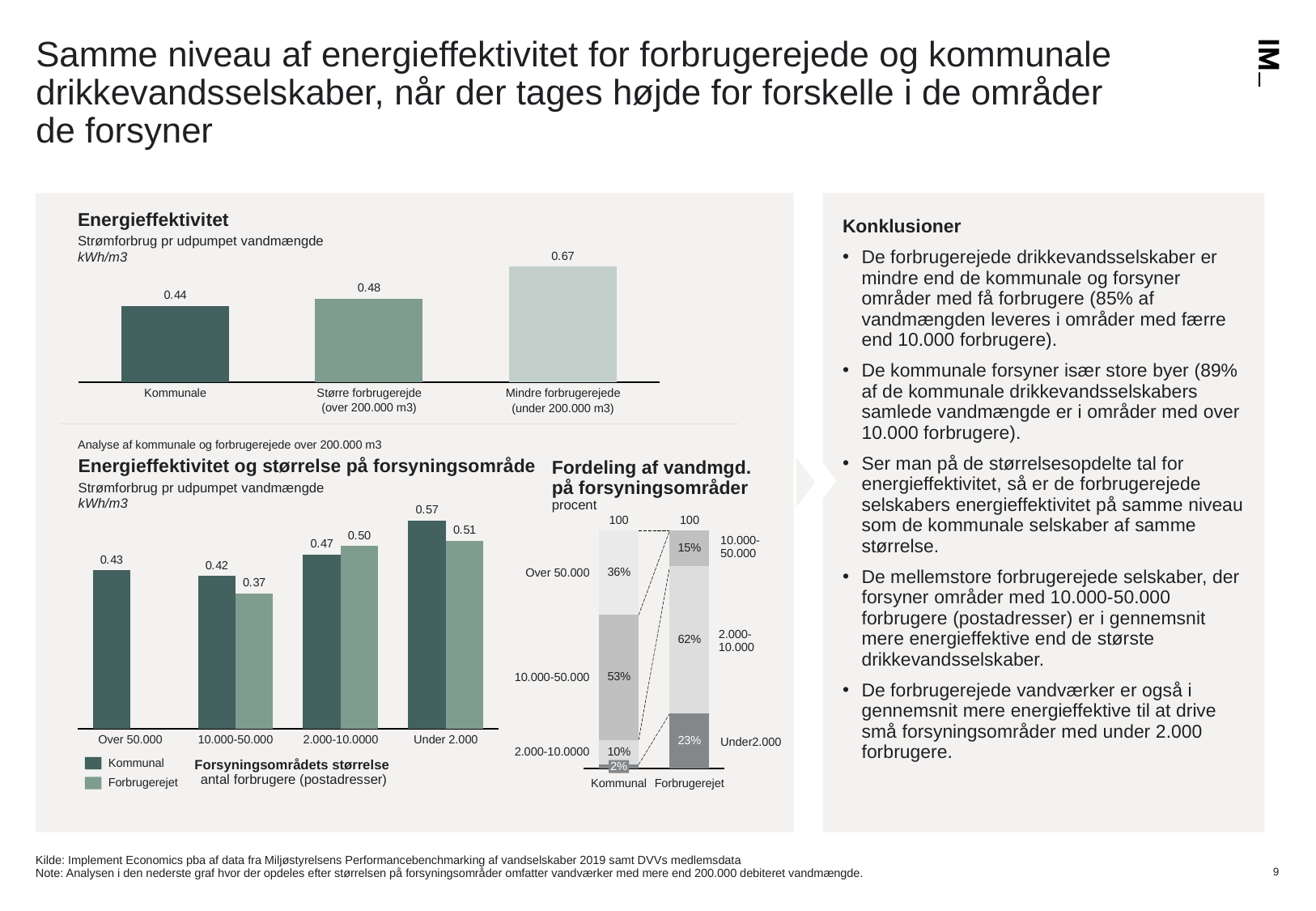
In the 'Energieffektivitet' chart, how many categories are shown? 3 In the 'Energieffektivitet' chart, what is the difference between Mindre forbrugerejede and Kommunale? 0.23 In the 'Energieffektivitet og størrelse på forsyningsområde' chart, which is larger for 2.000-10.0000: Kommunal or Forbrugerejet? Forbrugerejet In the 'Energieffektivitet og størrelse på forsyningsområde' chart, how many series does the legend list? 2 In the 'Energieffektivitet' chart, which category has the highest value? Mindre forbrugerejede (under 200.000 m3) In the 'Energieffektivitet og størrelse på forsyningsområde' chart, what is the Kommunal value for Under 2.000? 0.57 In the 'Fordeling af vandmgd. på forsyningsområder' chart, what share of the Kommunal bar is 10.000-50.000? 53% In the 'Fordeling af vandmgd. på forsyningsområder' chart, what is the difference between the Forbrugerejet and Kommunal values for 2.000-10.000? 52% In the 'Energieffektivitet' chart, what is the value for Kommunale? 0.44 In the 'Fordeling af vandmgd. på forsyningsområder' chart, what is the Forbrugerejet value for Under 2.000? 23% In the 'Energieffektivitet og størrelse på forsyningsområde' chart, what is the Forbrugerejet value for 10.000-50.000? 0.37 What kind of chart is 'Energieffektivitet og størrelse på forsyningsområde'? Bar chart